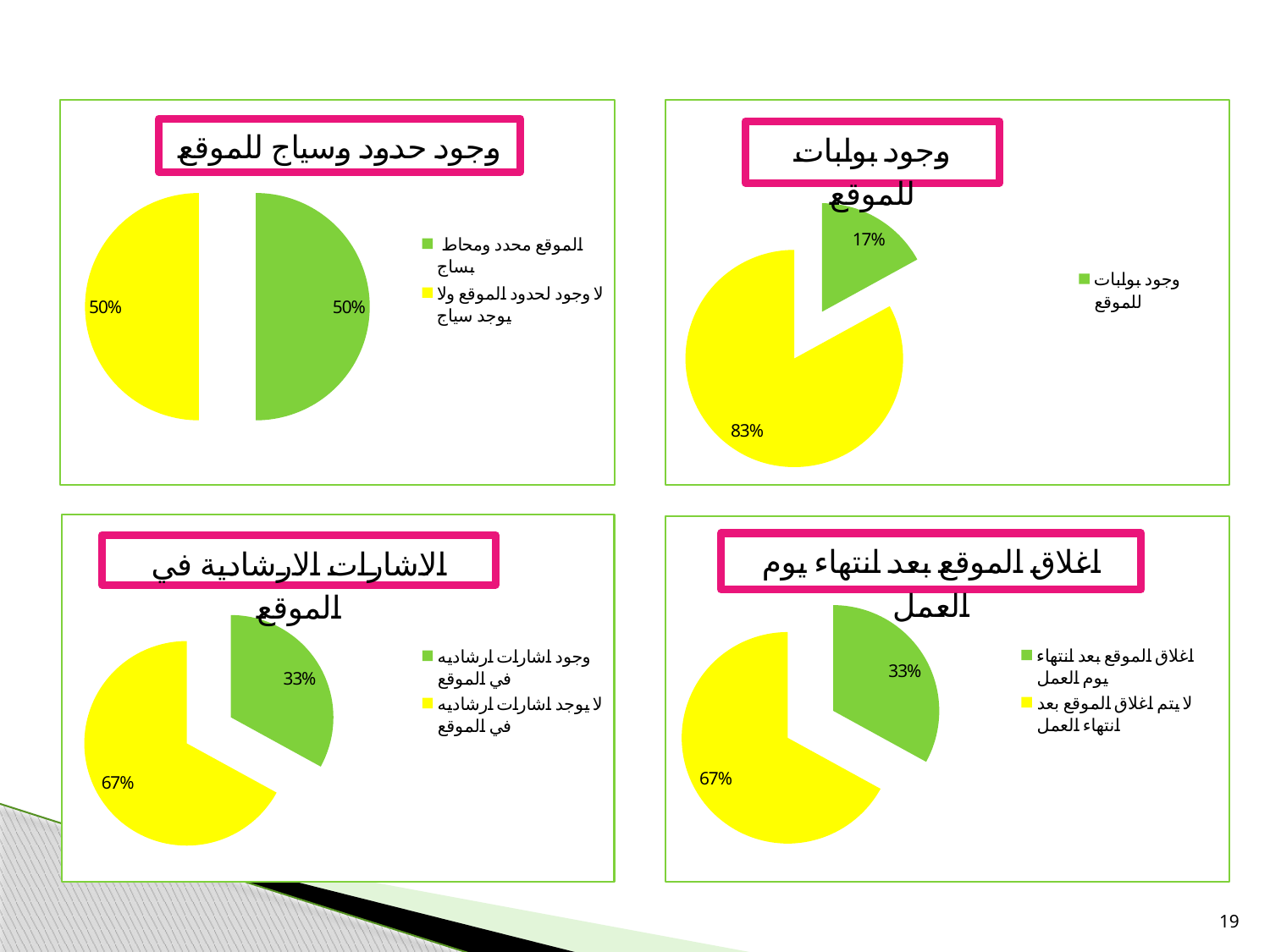
In the bottom-left chart "الاشارات الارشادية في الموقع", which slice is larger: "وجود اشارات ارشاديه في الموقع" or "لا يوجد اشارات ارشاديه في الموقع"? لا يوجد اشارات ارشاديه في الموقع In the bottom-left chart "الاشارات الارشادية في الموقع", what share is shown for "وجود اشارات ارشاديه في الموقع"? 33% In the top-right chart "وجود بوابات للموقع", what percentage is shown on the yellow slice? 83% How many pie charts are shown on the slide? 4 In the bottom-right chart "اغلاق الموقع بعد انتهاء يوم العمل", what share is shown for "لا يتم اغلاق الموقع بعد انتهاء العمل"? 67% How many entries does the legend of the bottom-right chart "اغلاق الموقع بعد انتهاء يوم العمل" list? 2 In the top-left chart "وجود حدود وسياج للموقع", what share is shown for "الموقع محدد ومحاط بسياج"? 50% What kind of chart is the top-left chart titled "وجود حدود وسياج للموقع"? Pie chart In the bottom-right chart "اغلاق الموقع بعد انتهاء يوم العمل", which category has the smallest share? اغلاق الموقع بعد انتهاء يوم العمل In the top-right chart "وجود بوابات للموقع", what percentage is shown on the green slice? 17% How many slices does the top-left pie chart "وجود حدود وسياج للموقع" have? 2 In the top-right chart "وجود بوابات للموقع", what is the difference between the yellow slice and the green slice? 66%